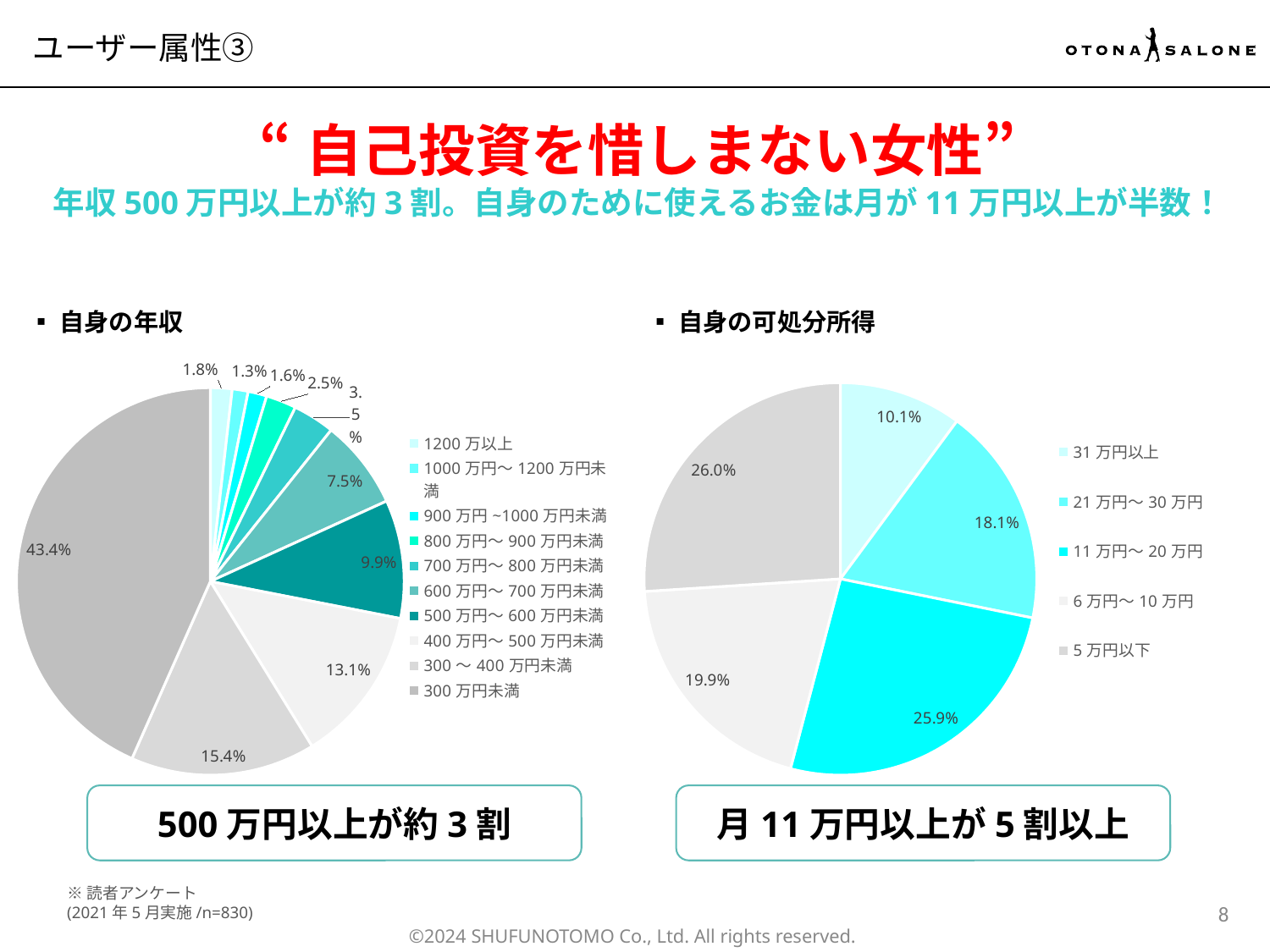
In the 自身の年収 pie chart, how many categories does the legend list? 10 In the 自身の年収 pie chart, what is the difference between the 300〜400万円未満 share and the 400万円〜500万円未満 share? 2.3% In the 自身の可処分所得 pie chart, how many categories does the legend list? 5 In the 自身の可処分所得 pie chart, which category has the smallest share? 31万円以上 In the 自身の可処分所得 pie chart, which is larger: the share for 21万円〜30万円 or the share for 6万円〜10万円? 6万円〜10万円 In the 自身の可処分所得 pie chart, what is the combined share of 21万円〜30万円 and 31万円以上? 28.2% What type of chart is used for 自身の年収? Pie chart In the 自身の年収 pie chart, what percentage is shown for 500万円〜600万円未満? 9.9% In the 自身の年収 pie chart, which category has the largest share? 300万円未満 In the 自身の可処分所得 pie chart, what percentage is shown for 11万円〜20万円? 25.9% In the 自身の年収 pie chart, what percentage is shown for 300万円未満? 43.4% In the 自身の可処分所得 pie chart, what percentage is shown for 31万円以上? 10.1%